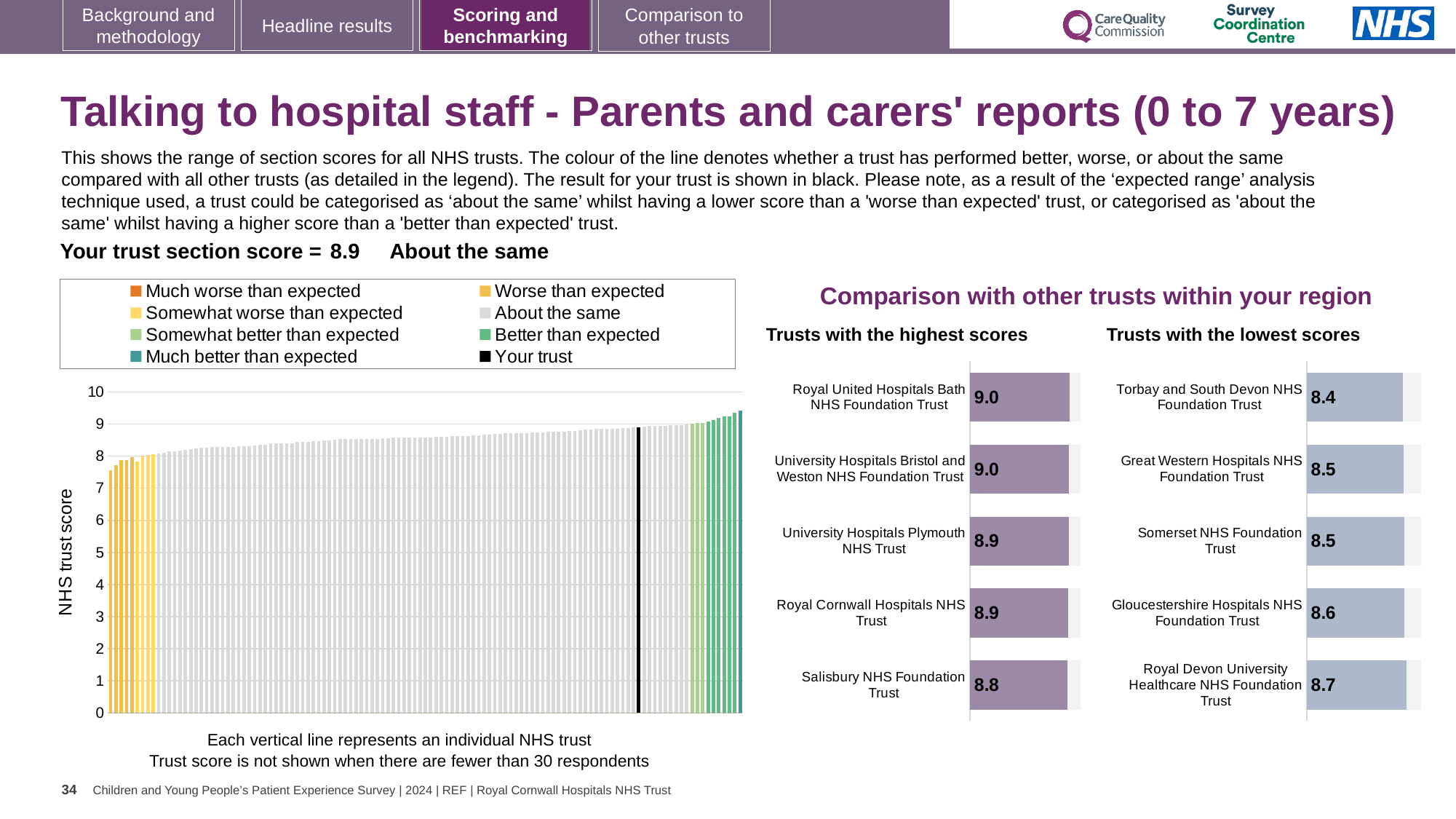
In the 'Trusts with the lowest scores' chart, which has the larger score: Gloucestershire Hospitals NHS Foundation Trust or Torbay and South Devon NHS Foundation Trust? Gloucestershire Hospitals NHS Foundation Trust In the large chart on the left, do the trust scores rise or fall from left to right? rise In the large chart on the left, is the value for 'Your trust' greater or less than 8? greater In the 'Trusts with the highest scores' chart, which trust has the lowest score? Salisbury NHS Foundation Trust How many entries does the legend of the large chart on the left list? 8 In the 'Trusts with the highest scores' chart, what is the score for Salisbury NHS Foundation Trust? 8.8 What type of chart is the large chart on the left of the slide? bar chart In the 'Trusts with the highest scores' chart, what is the score for University Hospitals Plymouth NHS Trust? 8.9 How many trusts are listed in the 'Trusts with the highest scores' chart? 5 In the 'Trusts with the lowest scores' chart, what is the score for Torbay and South Devon NHS Foundation Trust? 8.4 In the 'Trusts with the lowest scores' chart, what is the difference between the scores of Royal Devon University Healthcare NHS Foundation Trust and Torbay and South Devon NHS Foundation Trust? 0.3 In the 'Trusts with the lowest scores' chart, which trust has the highest score? Royal Devon University Healthcare NHS Foundation Trust